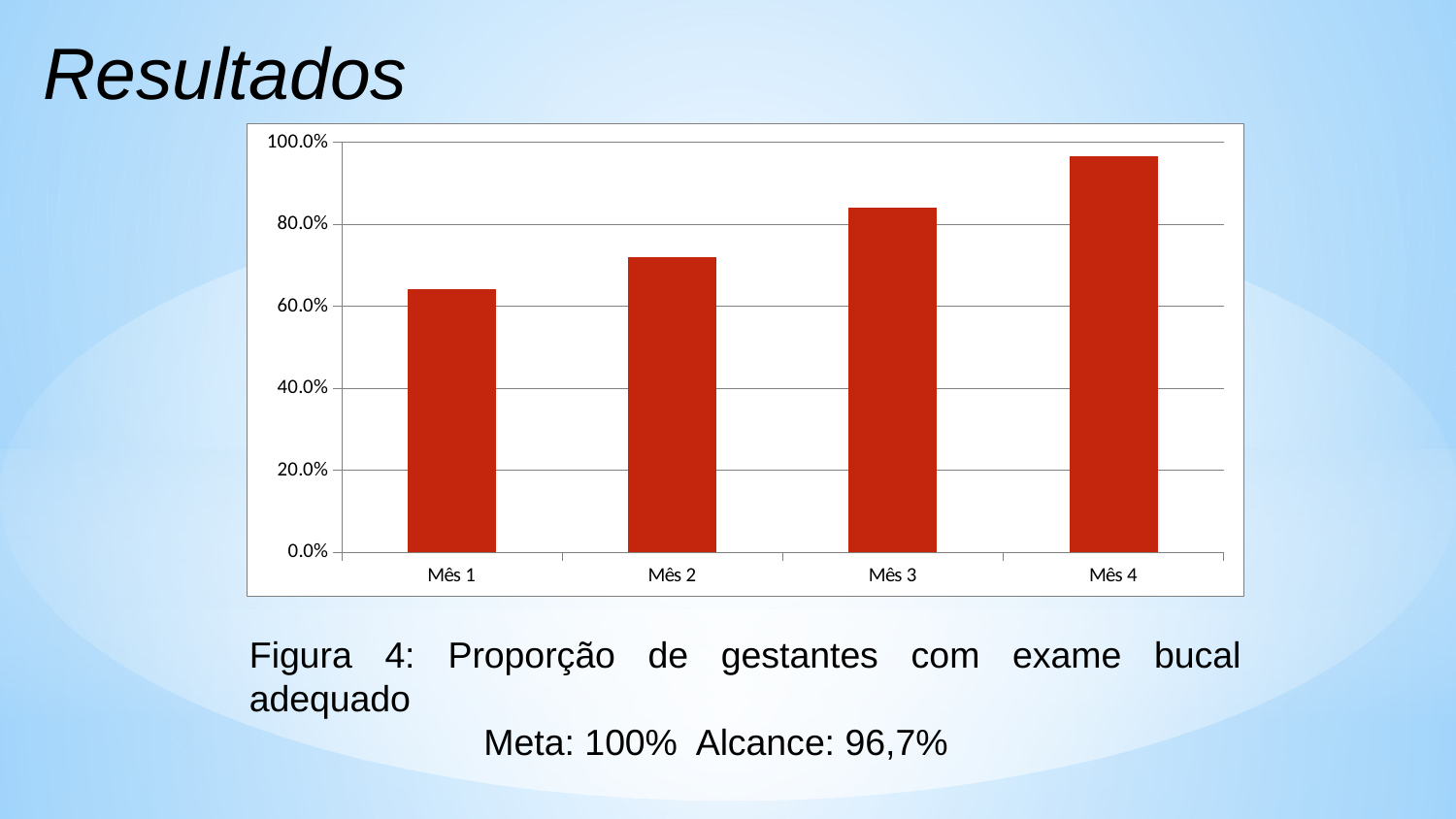
Is the value for Mês 2 greater or less than 80.0%? less Do the values rise or fall from Mês 1 to Mês 4? rise What colour are the bars in the chart? red What is the figure caption given below the chart? Figura 4: Proporção de gestantes com exame bucal adequado Is the value for Mês 1 greater or less than 60.0%? greater Is the value for Mês 4 greater or less than 100.0%? less Which is larger, the value for Mês 2 or the value for Mês 3? Mês 3 How many categories (months) are shown on the x axis of the chart? 4 What kind of chart is shown on the slide? bar chart Which month has the highest bar in the chart? Mês 4 Which month has the lowest bar in the chart? Mês 1